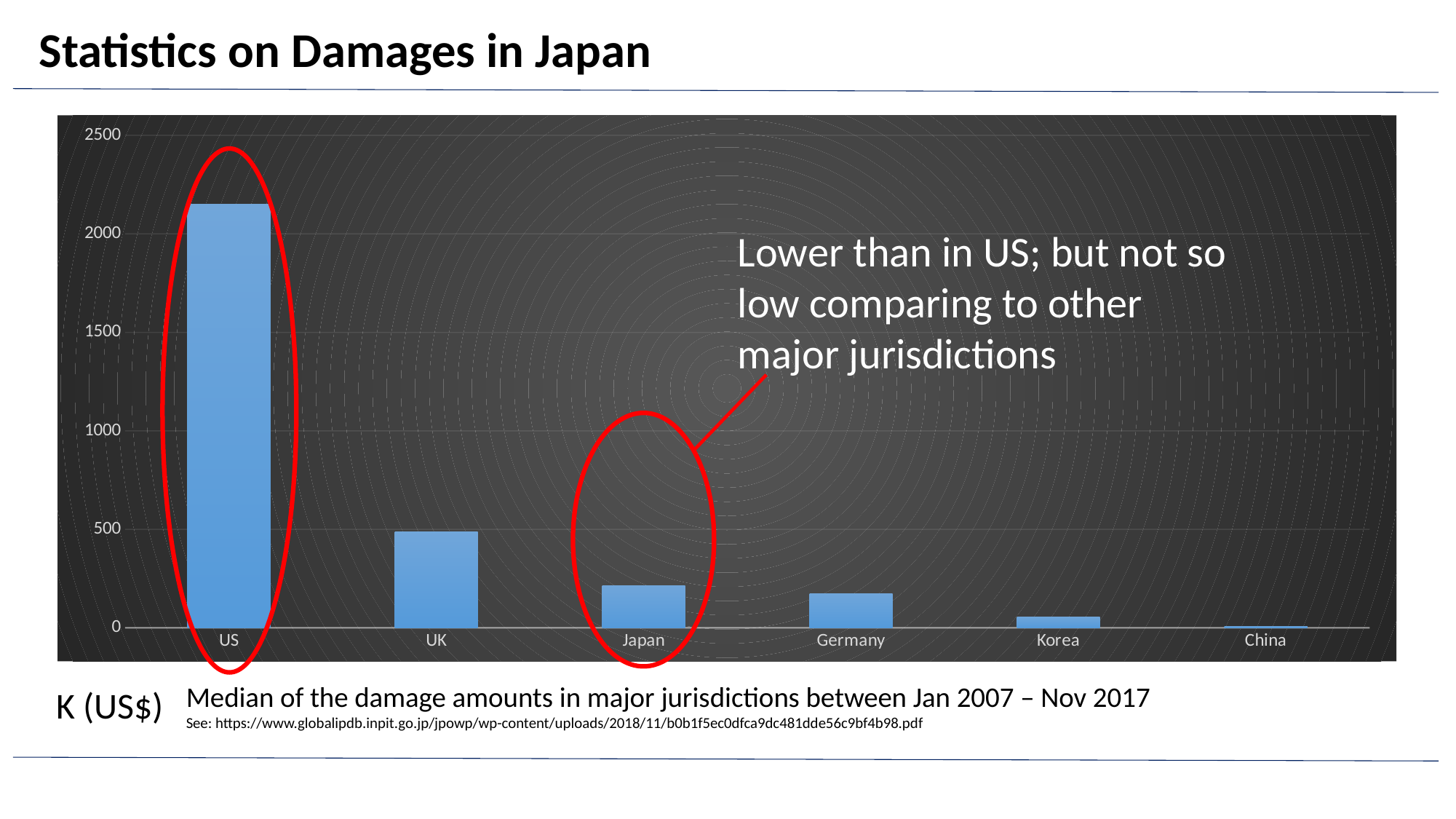
Which has a larger value, UK or Japan? UK Which has a larger value, Japan or Korea? Japan Which country has the highest median damage amount in the chart? US Which country has the lowest median damage amount in the chart? China Is the value for US greater or less than 2000? greater Is the value for US greater or less than 2500? less What unit is given for the values in the chart? K (US$) What kind of chart is shown on the slide? bar chart Do the bar values rise or fall moving from left to right along the x axis? fall Is the value for Germany greater or less than 500? less How many countries are shown on the x axis of the chart? 6